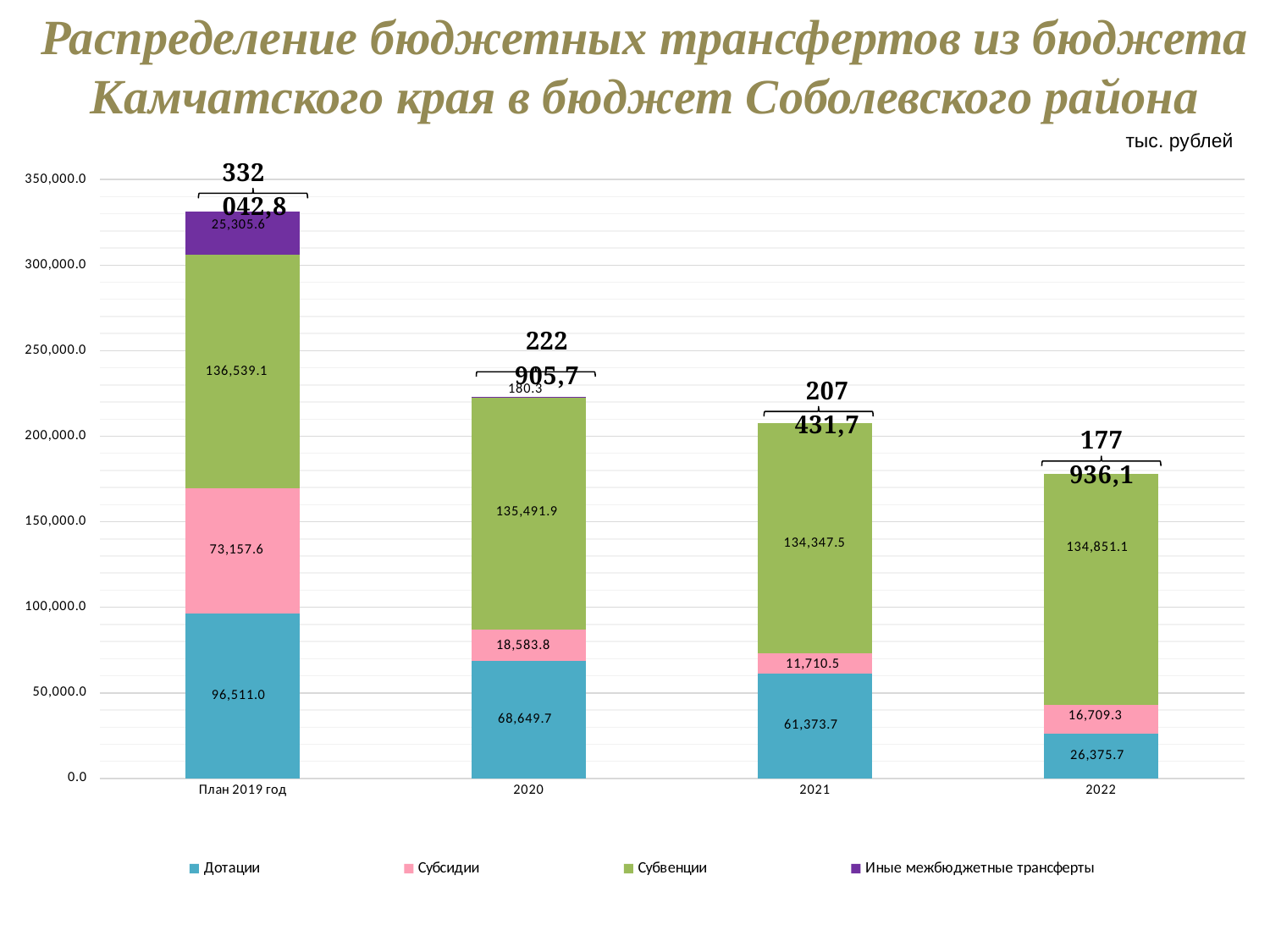
How many categories are shown on the x axis? 4 What is the value of Субсидии for 2022? 16,709.3 What type of chart is shown on the slide? Stacked bar chart Do the total bar heights rise or fall from План 2019 год to 2022? Fall What is the difference between Дотации for 2020 and Дотации for 2021? 7,276.0 What is the total labelled above the bar for 2020? 222 905,7 What is the value of Иные межбюджетные трансферты for План 2019 год? 25,305.6 Which category has the lowest total bar? 2022 What is the value of Дотации for План 2019 год? 96,511.0 What is the value of Субвенции for 2021? 134,347.5 Which category has the highest total bar? План 2019 год How many series does the legend list? 4